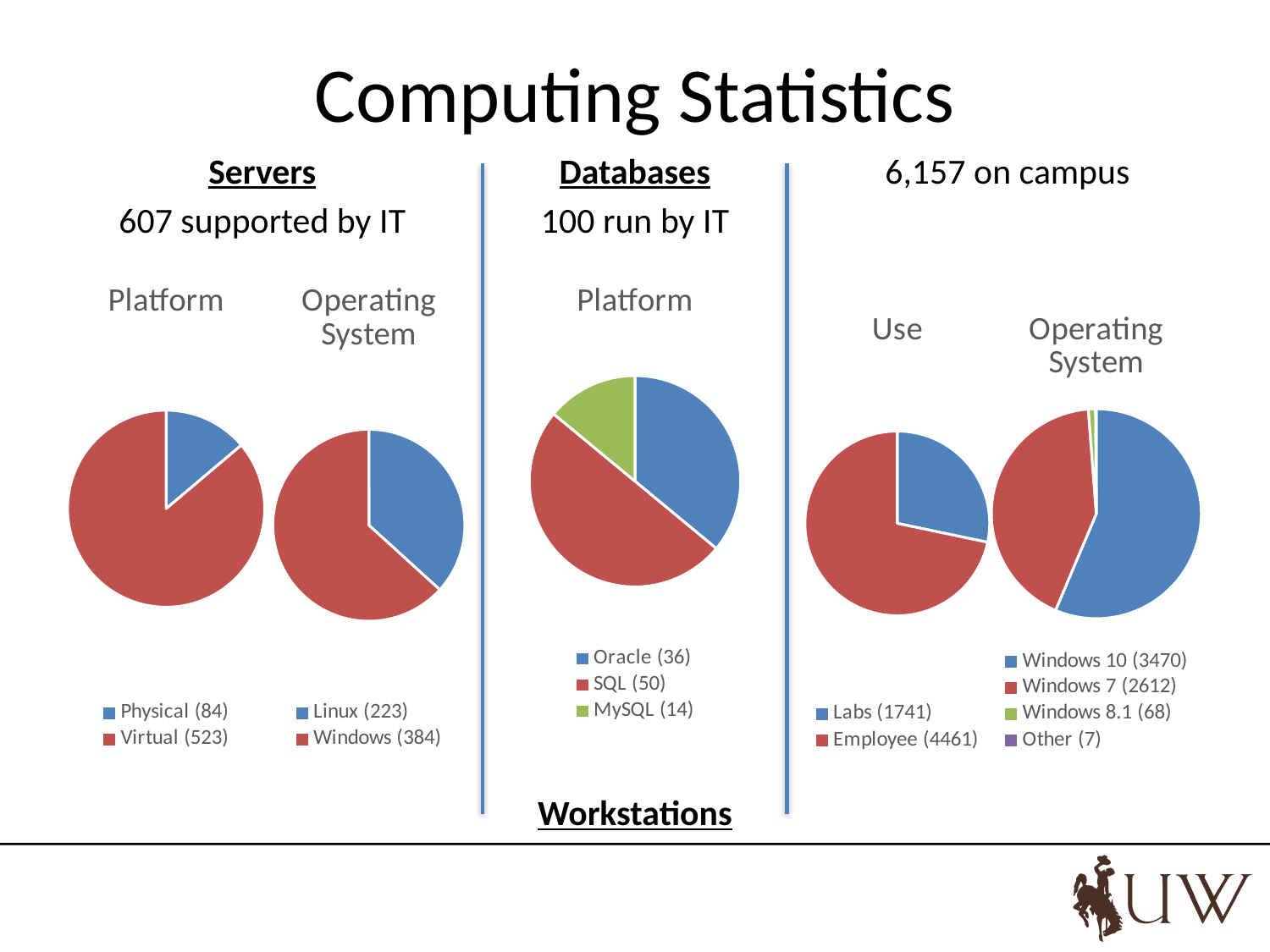
In the Workstations Operating System pie chart, how many workstations run Windows 8.1? 68 In the Databases Platform pie chart, what colour is the MySQL slice? Green In the Workstations Use pie chart, which is larger, Labs or Employee? Employee In the Workstations Operating System pie chart, what is the difference between Windows 10 and Windows 7 counts? 858 In the Servers Platform pie chart, how many servers are Virtual? 523 In the Databases Platform pie chart, which platform has the smallest slice? MySQL In the Workstations Operating System pie chart, how many categories does the legend list? 4 What kind of chart is used for the Servers Platform data? Pie chart In the Databases Platform pie chart, which platform has the largest slice? SQL In the Servers Operating System pie chart, how many servers run Linux? 223 In the Databases Platform pie chart, what is the difference between the SQL and Oracle counts? 14 In the Servers Platform pie chart, what is the difference between Virtual and Physical servers? 439